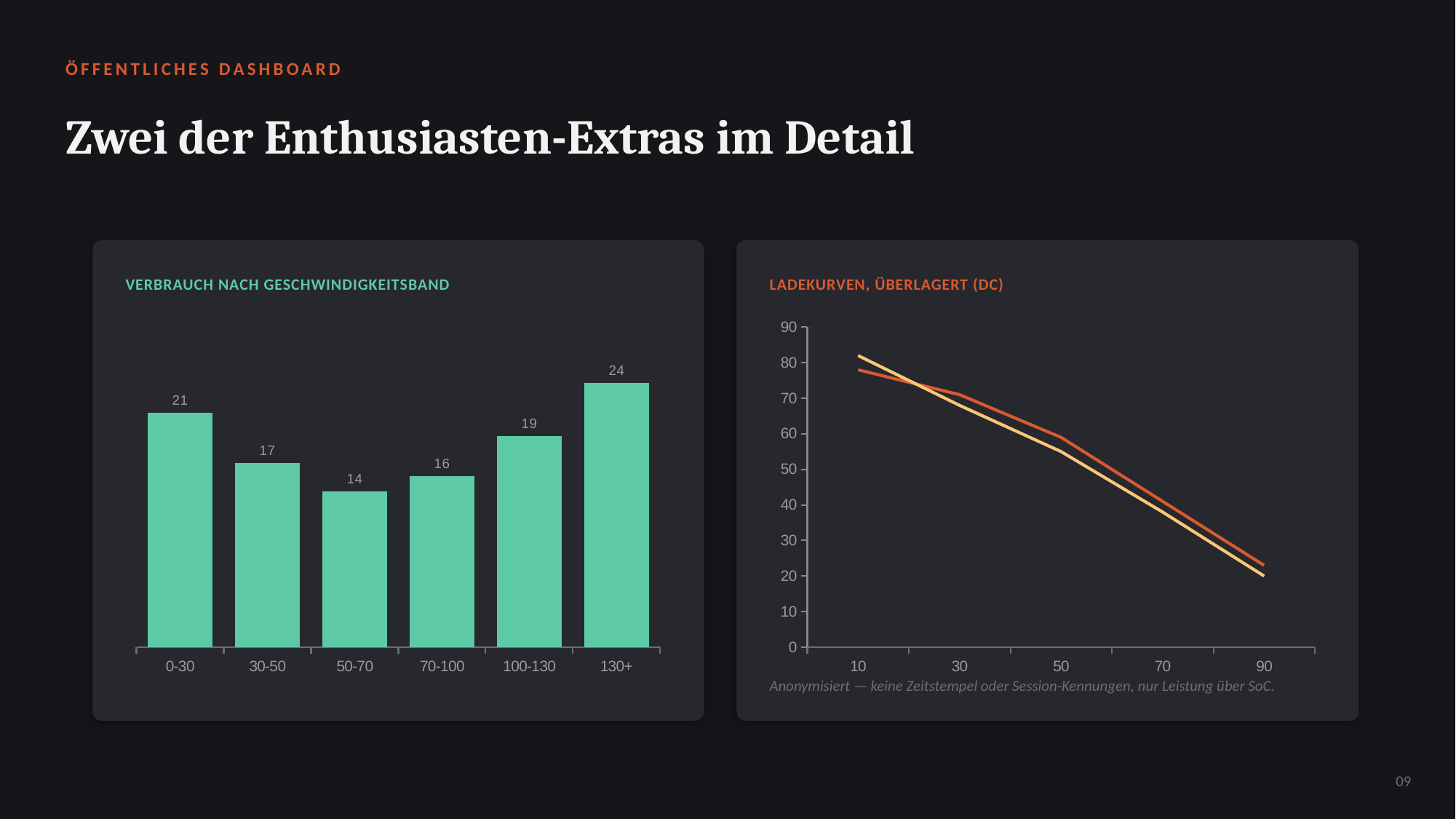
In the chart titled "Verbrauch nach Geschwindigkeitsband", what is the value for the 50-70 band? 14 In the chart titled "Ladekurven, überlagert (DC)", is the value of the orange line at x = 10 greater or less than 70? greater In the chart titled "Ladekurven, überlagert (DC)", do the lines rise or fall as the x-axis value increases from 10 to 90? Fall In the chart titled "Verbrauch nach Geschwindigkeitsband", what is the difference between the values for 130+ and 0-30? 3 In the chart titled "Ladekurven, überlagert (DC)", is the value of the yellow line at x = 50 greater or less than 50? greater In the chart titled "Verbrauch nach Geschwindigkeitsband", which speed band has the highest value? 130+ In the chart titled "Verbrauch nach Geschwindigkeitsband", what is the value for the 100-130 band? 19 In the chart titled "Verbrauch nach Geschwindigkeitsband", which is larger, the value for 30-50 or the value for 70-100? 30-50 What kind of chart is the right chart, "Ladekurven, überlagert (DC)"? Line chart What kind of chart is the left chart, "Verbrauch nach Geschwindigkeitsband"? Bar chart How many speed bands are shown in the chart titled "Verbrauch nach Geschwindigkeitsband"? 6 In the chart titled "Verbrauch nach Geschwindigkeitsband", which speed band has the lowest value? 50-70